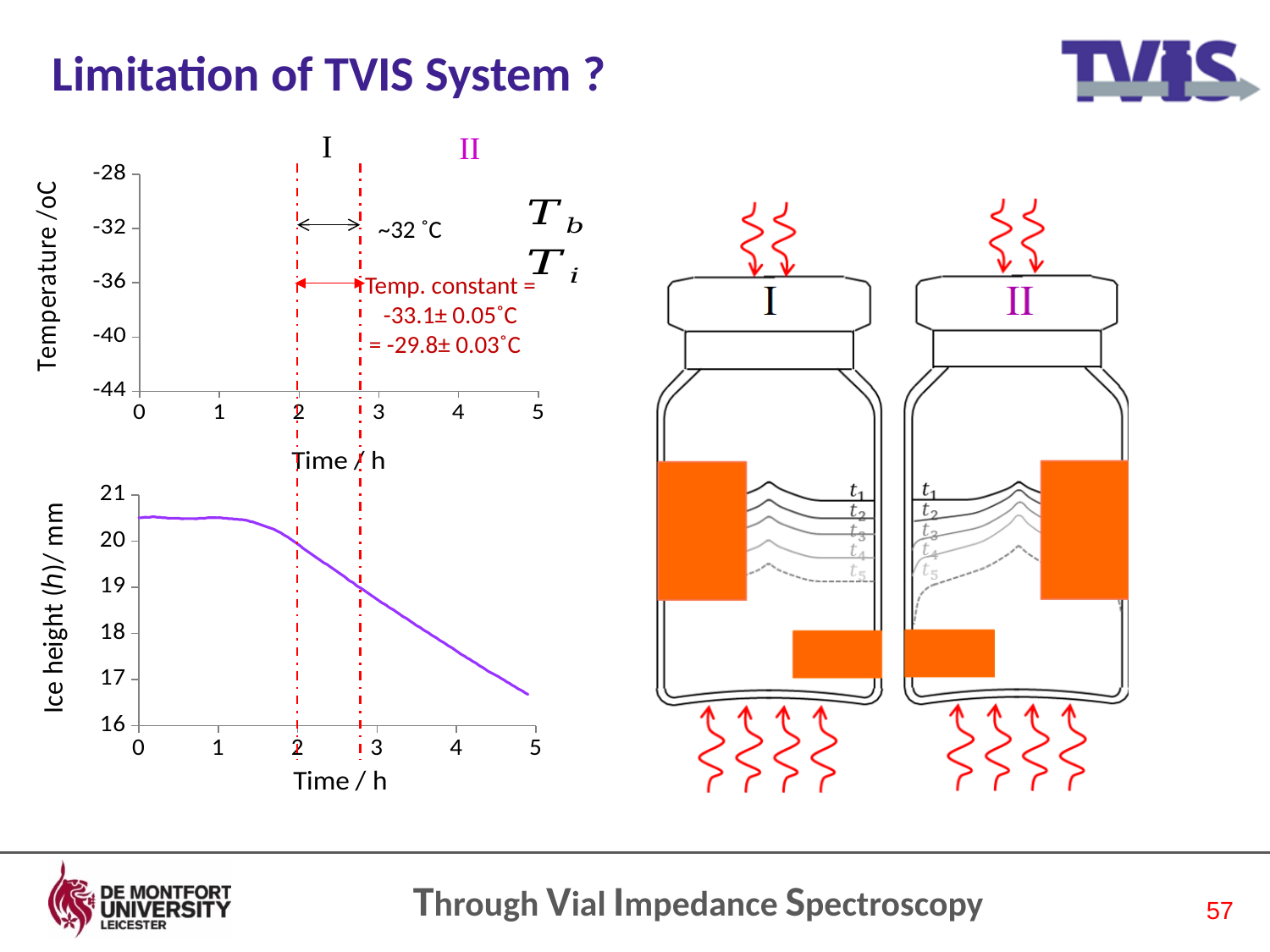
In the top chart (Temperature vs Time), what is the lowest value shown on the y axis? -44 What kind of chart is the bottom chart (Ice height vs Time)? line chart What is the y-axis label of the top chart? Temperature /oC In the bottom chart (Ice height vs Time), is the ice height at 1 h greater or less than 20 mm? greater In the bottom chart (Ice height vs Time), is the ice height larger at 1 h or at 4 h? 1 h In the top chart (Temperature vs Time), what is the highest value shown on the x axis? 5 In the bottom chart (Ice height vs Time), do the values rise or fall along the x axis overall? fall In the bottom chart (Ice height vs Time), is the ice height at the end of the line (near 5 h) greater or less than 17 mm? less What is the y-axis label of the bottom chart? Ice height (h)/ mm In the bottom chart (Ice height vs Time), what is the highest value shown on the y axis? 21 In the bottom chart (Ice height vs Time), is the ice height at time 0 h greater or less than 20 mm? greater How many data series are plotted in the bottom chart (Ice height vs Time)? 1